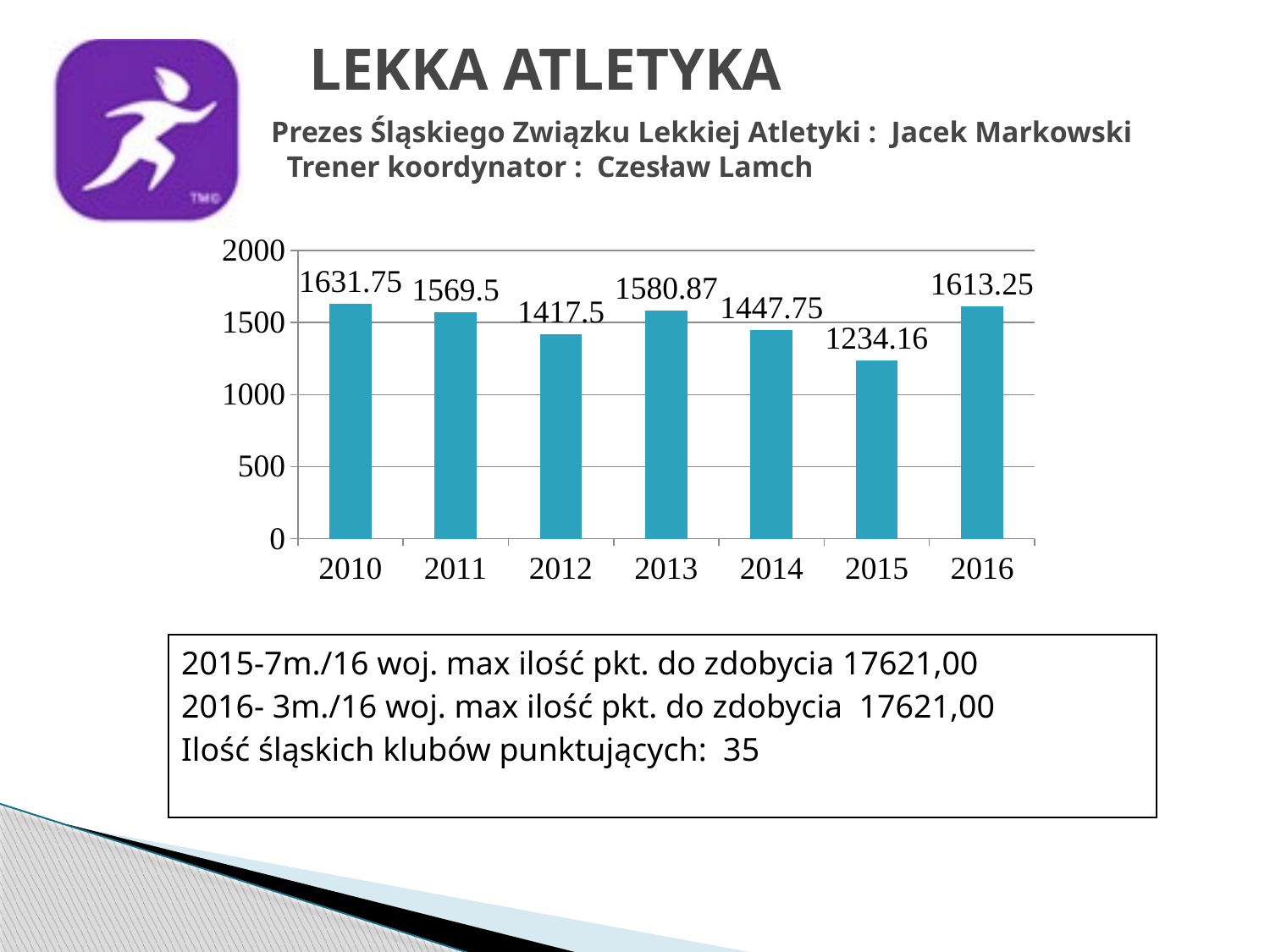
What is the value shown for 2013? 1580.87 What kind of chart is shown on the slide? bar chart What is the difference between the values for 2014 and 2012? 30.25 How many years are shown on the x axis? 7 What is the value shown for 2010? 1631.75 What is the value shown for 2015? 1234.16 Is the value for 2015 greater or less than 1500? less Which is larger, the value for 2011 or the value for 2013? 2013 Which year has the highest value? 2010 What is the difference between the values for 2010 and 2016? 18.5 Which year has the lowest value? 2015 What is the value shown for 2016? 1613.25